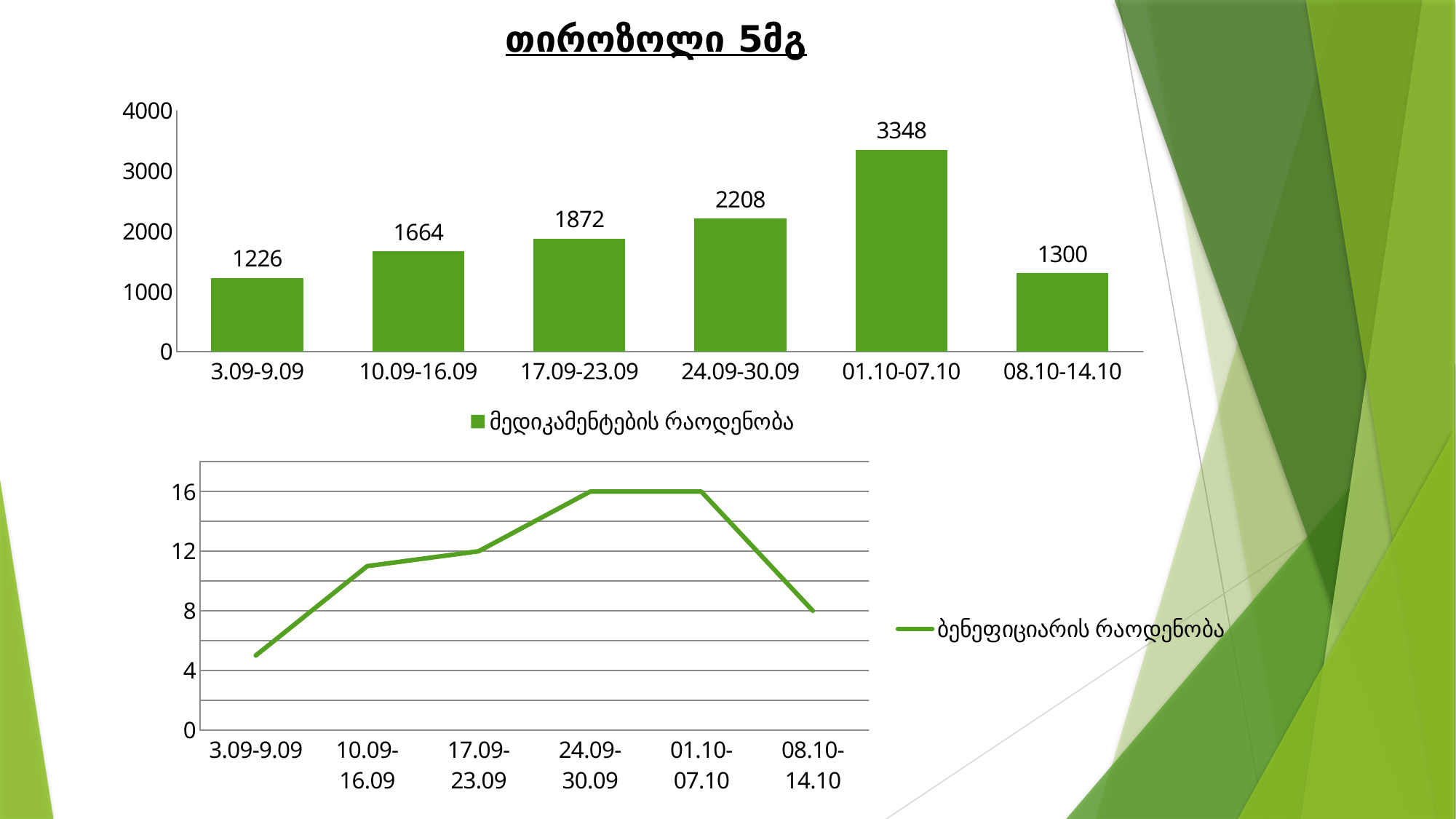
What kind of chart is the top chart on the slide? bar chart In the top bar chart, which period has the highest value? 01.10-07.10 In the top bar chart, how many periods are shown on the x axis? 6 In the bottom line chart, do the values rise or fall from 01.10-07.10 to 08.10-14.10? fall In the top bar chart, what is the value for 01.10-07.10? 3348 In the bottom line chart, is the value for 3.09-9.09 greater or less than 8? less What kind of chart is the bottom chart on the slide? line chart In the top bar chart, which is larger: the value for 17.09-23.09 or the value for 24.09-30.09? 24.09-30.09 In the top bar chart, what is the value for 3.09-9.09? 1226 In the top bar chart, what is the difference between the values for 01.10-07.10 and 08.10-14.10? 2048 In the top bar chart, which period has the lowest value? 3.09-9.09 In the bottom line chart, what is the value for 24.09-30.09? 16